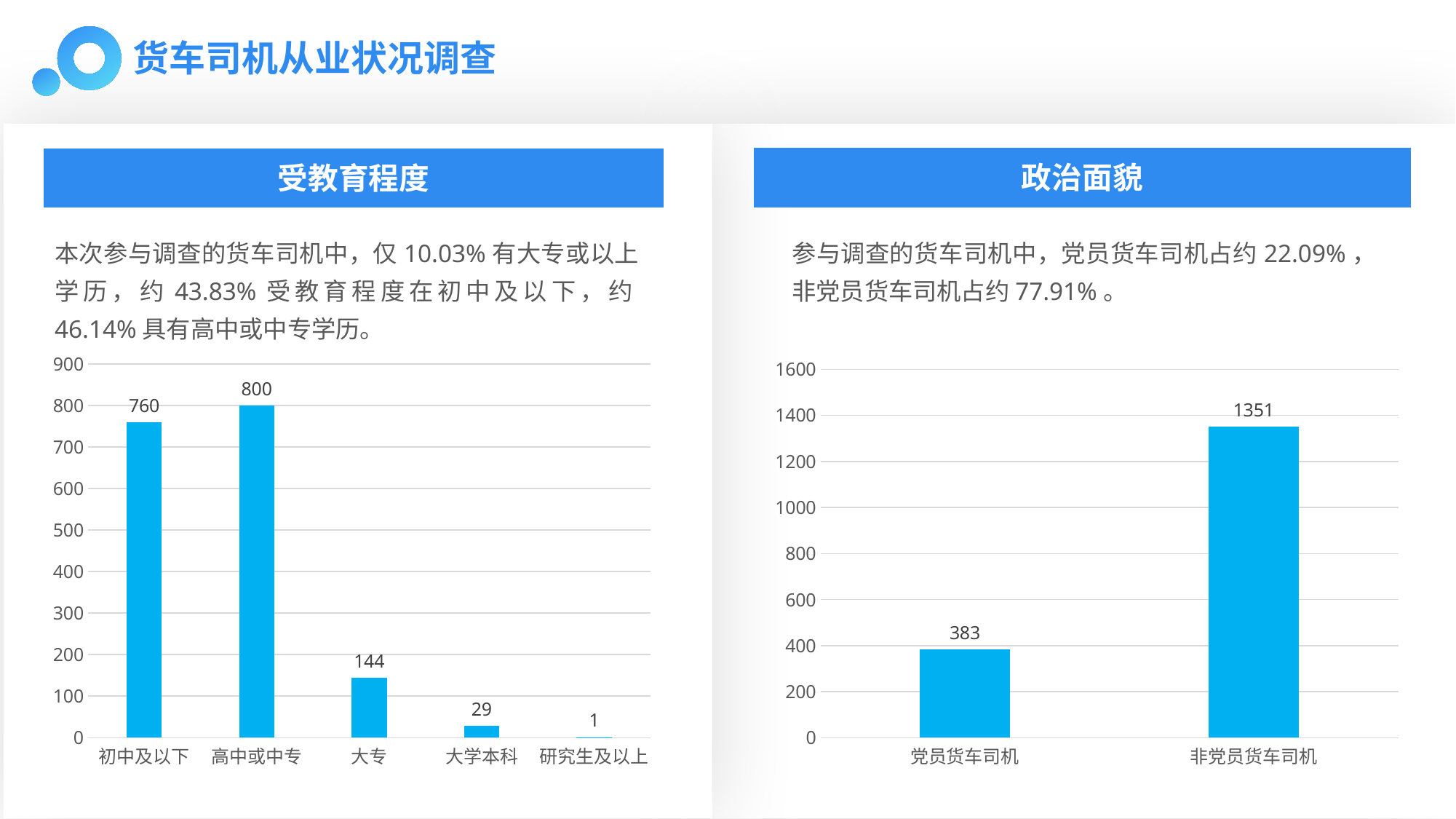
In the 受教育程度 chart, what is the difference between 高中或中专 and 初中及以下? 40 In the 受教育程度 chart, what is the value for 大学本科? 29 In the 政治面貌 chart, what is the value for 非党员货车司机? 1351 In the 受教育程度 chart, how many categories are shown on the x axis? 5 In the 受教育程度 chart, which category has the lowest value? 研究生及以上 In the 受教育程度 chart, is the value for 大专 greater or less than 200? less In the 政治面貌 chart, what is the value for 党员货车司机? 383 In the 受教育程度 chart, which category has the highest value? 高中或中专 In the 受教育程度 chart, what is the value for 高中或中专? 800 What kind of chart is the 政治面貌 chart? bar chart In the 政治面貌 chart, what is the difference between 非党员货车司机 and 党员货车司机? 968 In the 政治面貌 chart, which is larger, 党员货车司机 or 非党员货车司机? 非党员货车司机